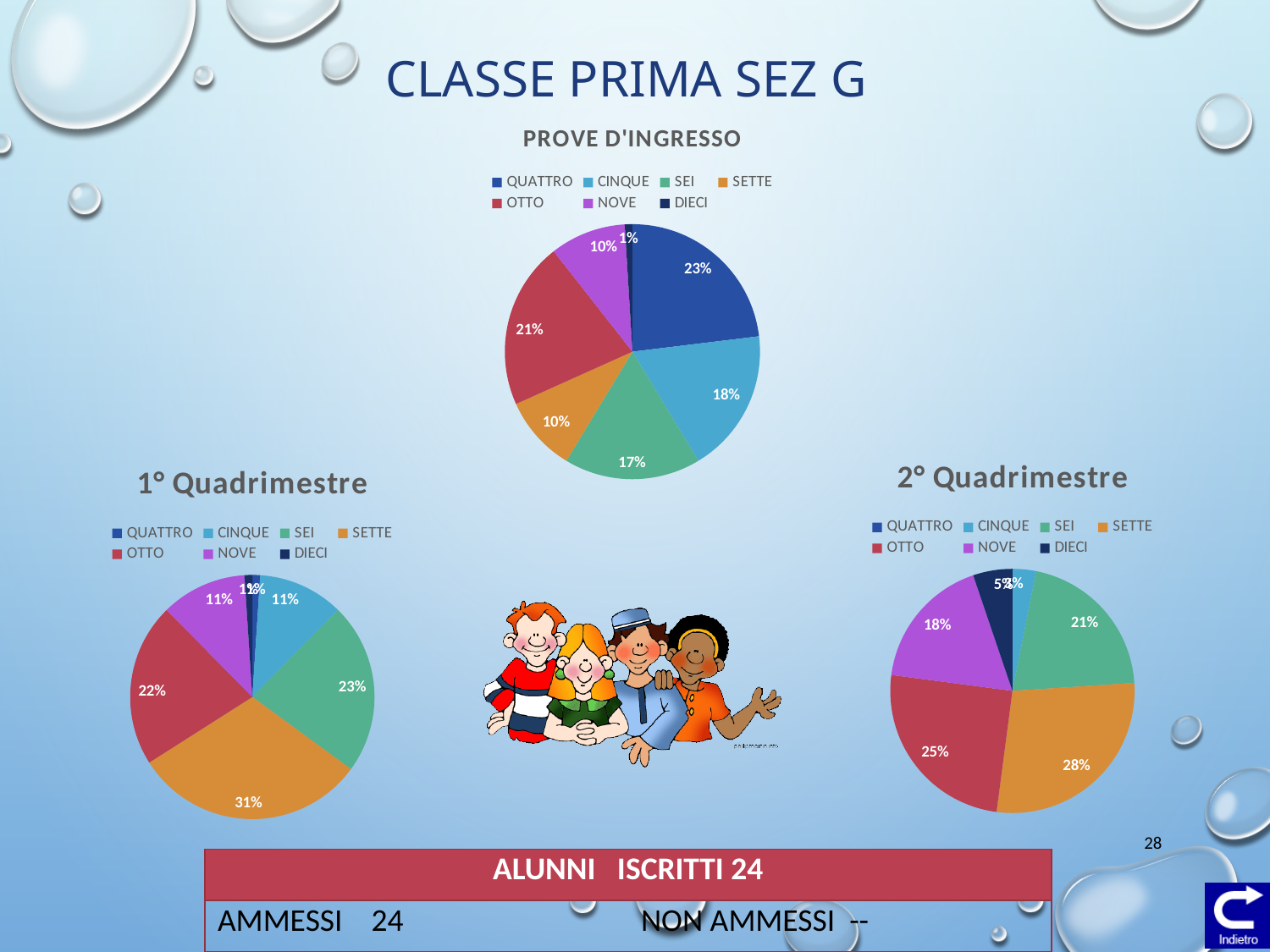
What type of chart is used for the 1° Quadrimestre data? Pie chart In the 1° Quadrimestre pie chart, what percentage is shown for SETTE? 31% How many categories does the legend of the PROVE D'INGRESSO chart list? 7 In the 2° Quadrimestre pie chart, what percentage is shown for SETTE? 28% In the 2° Quadrimestre pie chart, what percentage is shown for OTTO? 25% In the PROVE D'INGRESSO pie chart, which category has the largest slice? QUATTRO In the PROVE D'INGRESSO pie chart, what percentage is shown for OTTO? 21% In the 1° Quadrimestre pie chart, which category has the largest slice? SETTE In the 1° Quadrimestre pie chart, what is the difference in percentage points between SETTE and OTTO? 9 In the PROVE D'INGRESSO pie chart, what percentage is shown for SEI? 17% In the 2° Quadrimestre pie chart, which is larger, SEI or NOVE? SEI In the PROVE D'INGRESSO pie chart, what percentage is shown for QUATTRO? 23%